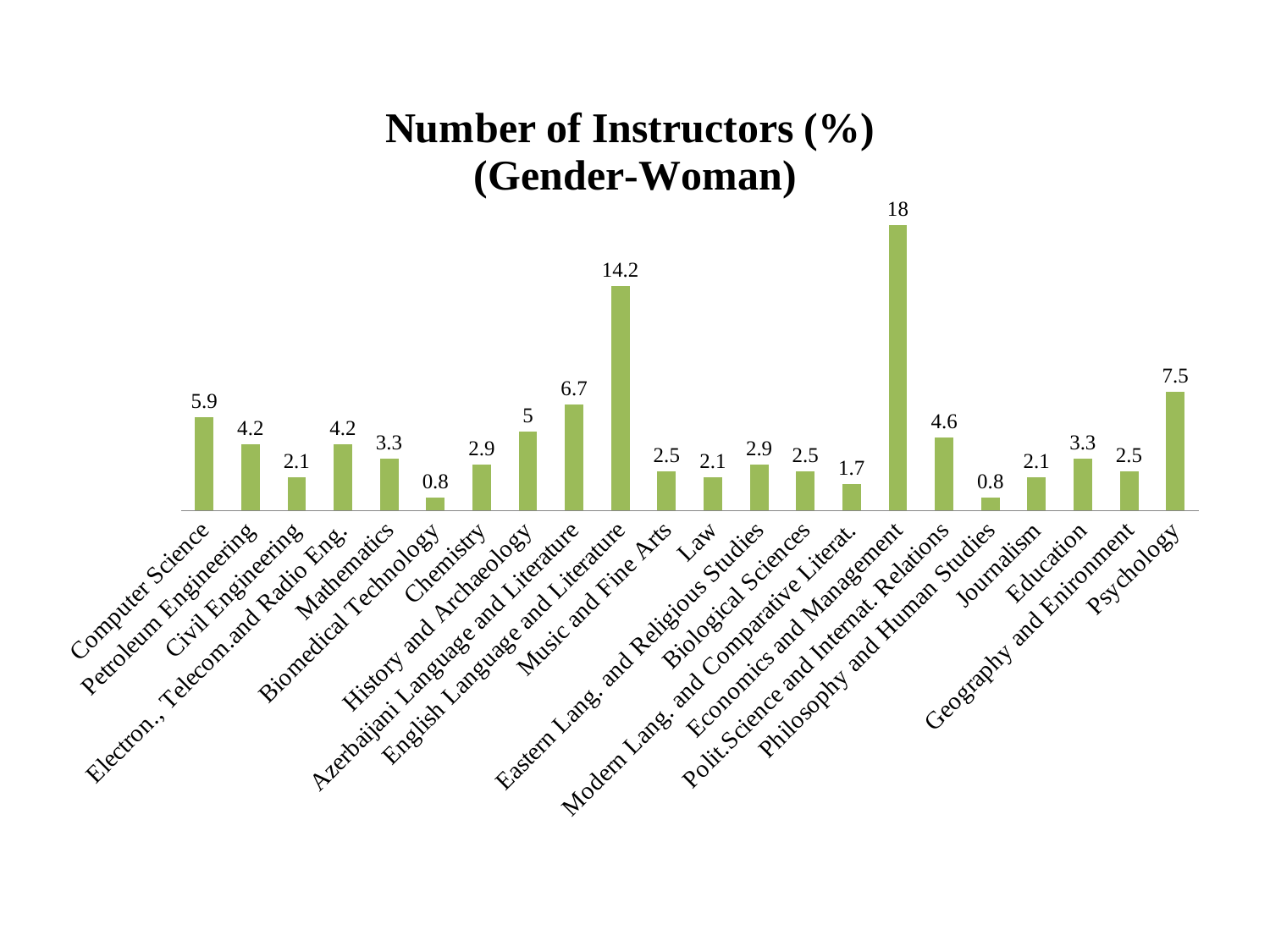
What is the value for Modern Lang. and Comparative Literat.? 1.7 What is the difference between the values for Computer Science and Chemistry? 3 What is the value for Polit.Science and Internat. Relations? 4.6 What is the difference between the values for Economics and Management and English Language and Literature? 3.8 How many categories are shown on the x axis? 22 What is the value for Psychology? 7.5 What is the title of the chart? Number of Instructors (%) (Gender-Woman) What kind of chart is shown on the slide? Bar chart What is the value for English Language and Literature? 14.2 What is the value for Economics and Management? 18 Which category has the highest value? Economics and Management Which is larger, the value for Azerbaijani Language and Literature or the value for History and Archaeology? Azerbaijani Language and Literature